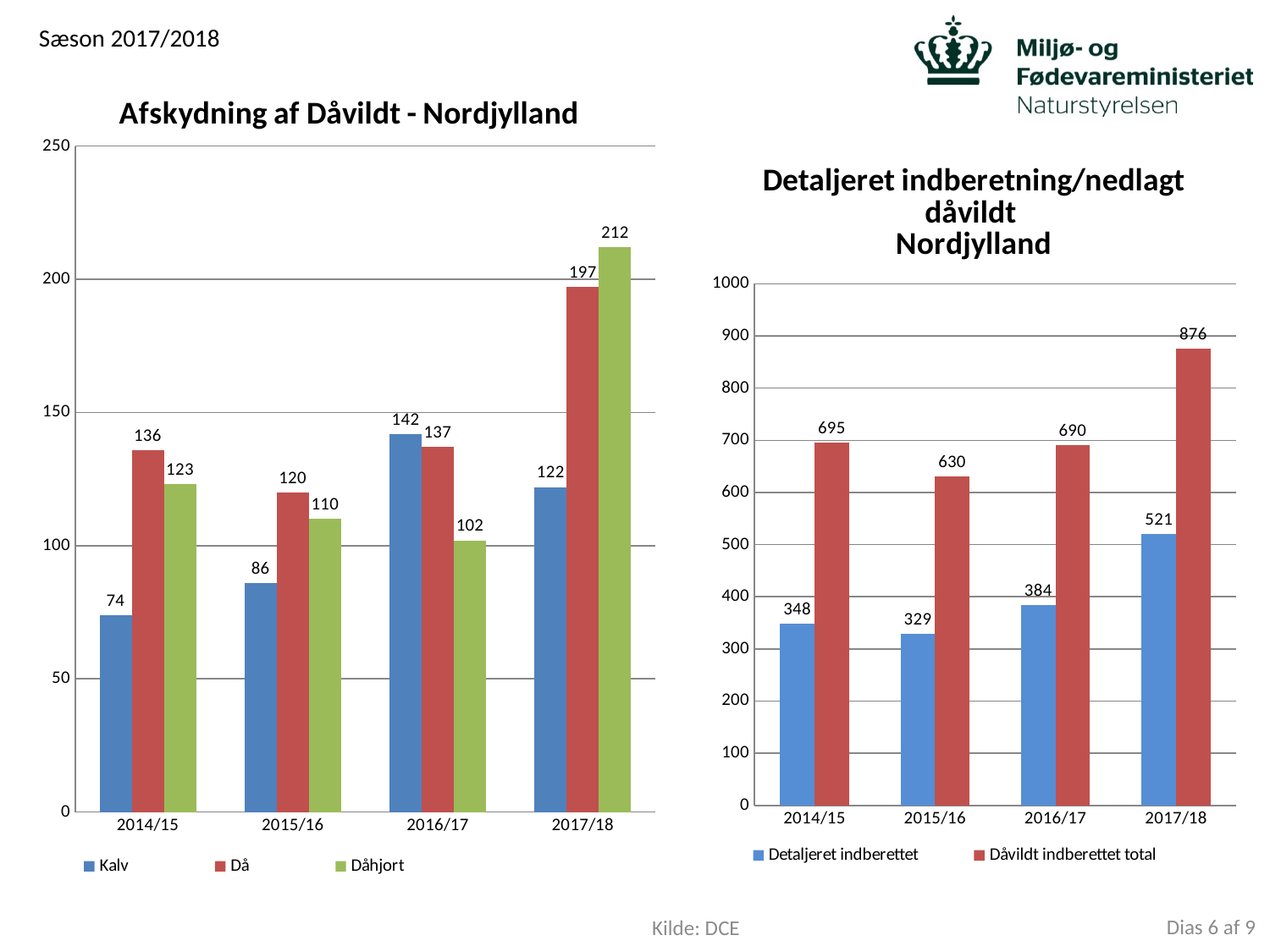
In the chart 'Detaljeret indberetning/nedlagt dåvildt Nordjylland', how many seasons are shown on the x axis? 4 In the chart 'Afskydning af Dåvildt - Nordjylland', how many series does the legend list? 3 What kind of chart is 'Detaljeret indberetning/nedlagt dåvildt Nordjylland'? Bar chart In the chart 'Detaljeret indberetning/nedlagt dåvildt Nordjylland', which season has the lowest value for Detaljeret indberettet? 2015/16 In the chart 'Detaljeret indberetning/nedlagt dåvildt Nordjylland', what colour are the bars for Dåvildt indberettet total? Red In the chart 'Detaljeret indberetning/nedlagt dåvildt Nordjylland', what is the difference between Dåvildt indberettet total and Detaljeret indberettet in 2014/15? 347 In the chart 'Afskydning af Dåvildt - Nordjylland', which season has the lowest value for Kalv? 2014/15 In the chart 'Afskydning af Dåvildt - Nordjylland', what is the difference between Då and Kalv in 2017/18? 75 In the chart 'Afskydning af Dåvildt - Nordjylland', what is the value for Kalv in 2014/15? 74 In the chart 'Afskydning af Dåvildt - Nordjylland', what is the value for Dåhjort in 2017/18? 212 In the chart 'Afskydning af Dåvildt - Nordjylland', which is larger in 2016/17, Kalv or Dåhjort? Kalv In the chart 'Detaljeret indberetning/nedlagt dåvildt Nordjylland', what is the value for Dåvildt indberettet total in 2017/18? 876